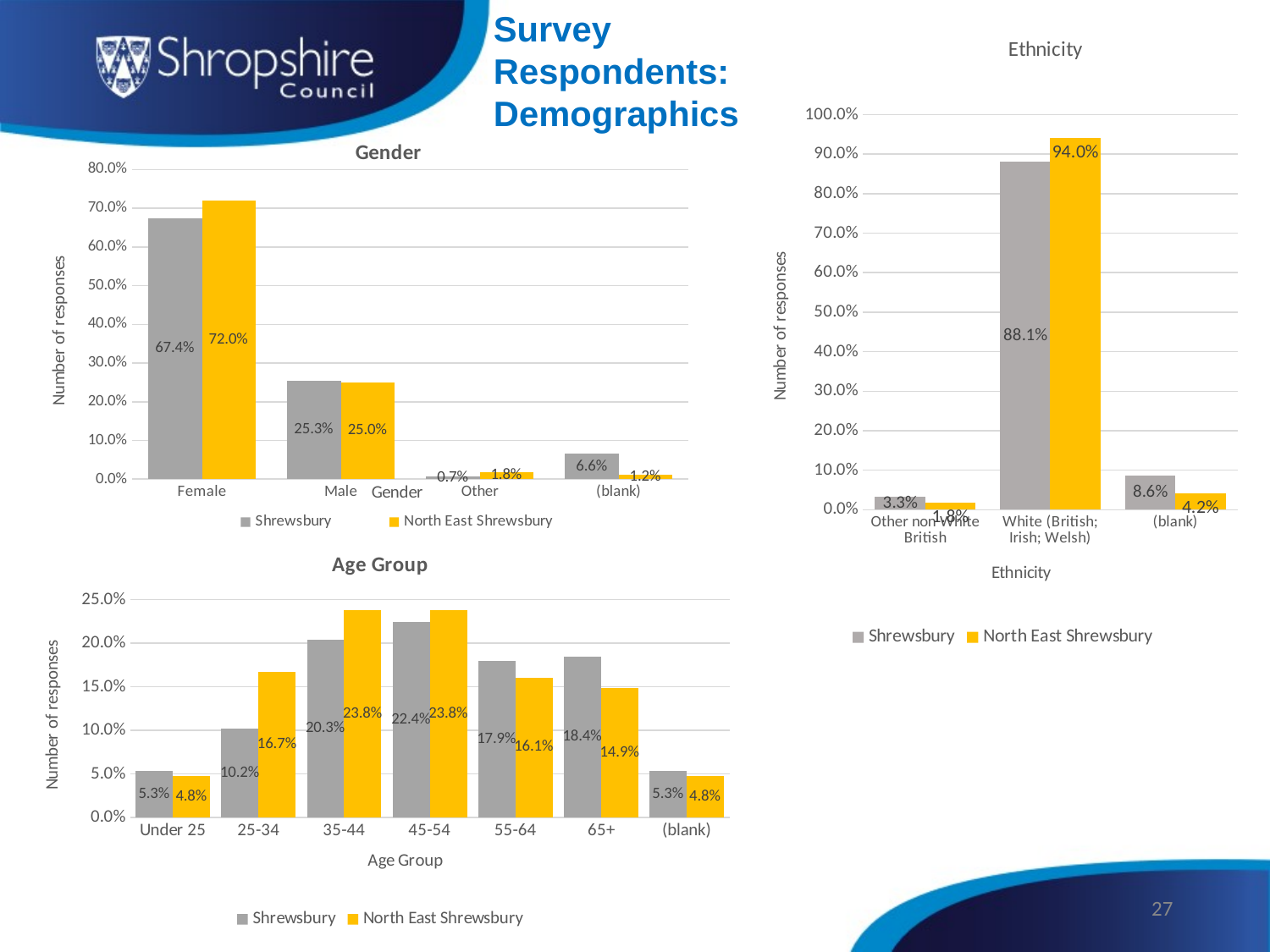
In the Gender chart, what is the difference between the Shrewsbury and North East Shrewsbury values for Female? 4.6% In the Gender chart, what is the value for Female in the Shrewsbury series? 67.4% In the Age Group chart, which is larger for 65+: the Shrewsbury value or the North East Shrewsbury value? Shrewsbury In the Age Group chart, which age group has the highest Shrewsbury value? 45-54 In the Gender chart, what is the value for Male in the North East Shrewsbury series? 25.0% In the Ethnicity chart, what is the difference between the Shrewsbury and North East Shrewsbury values for (blank)? 4.4% How many series does the legend of the Ethnicity chart list? 2 In the Age Group chart, what is the North East Shrewsbury value for 25-34? 16.7% In the Age Group chart, how many categories are shown on the x axis? 7 In the Gender chart, which category has the lowest Shrewsbury value? Other What type of chart is the Ethnicity chart? Bar chart In the Ethnicity chart, what is the North East Shrewsbury value for White (British; Irish; Welsh)? 94.0%